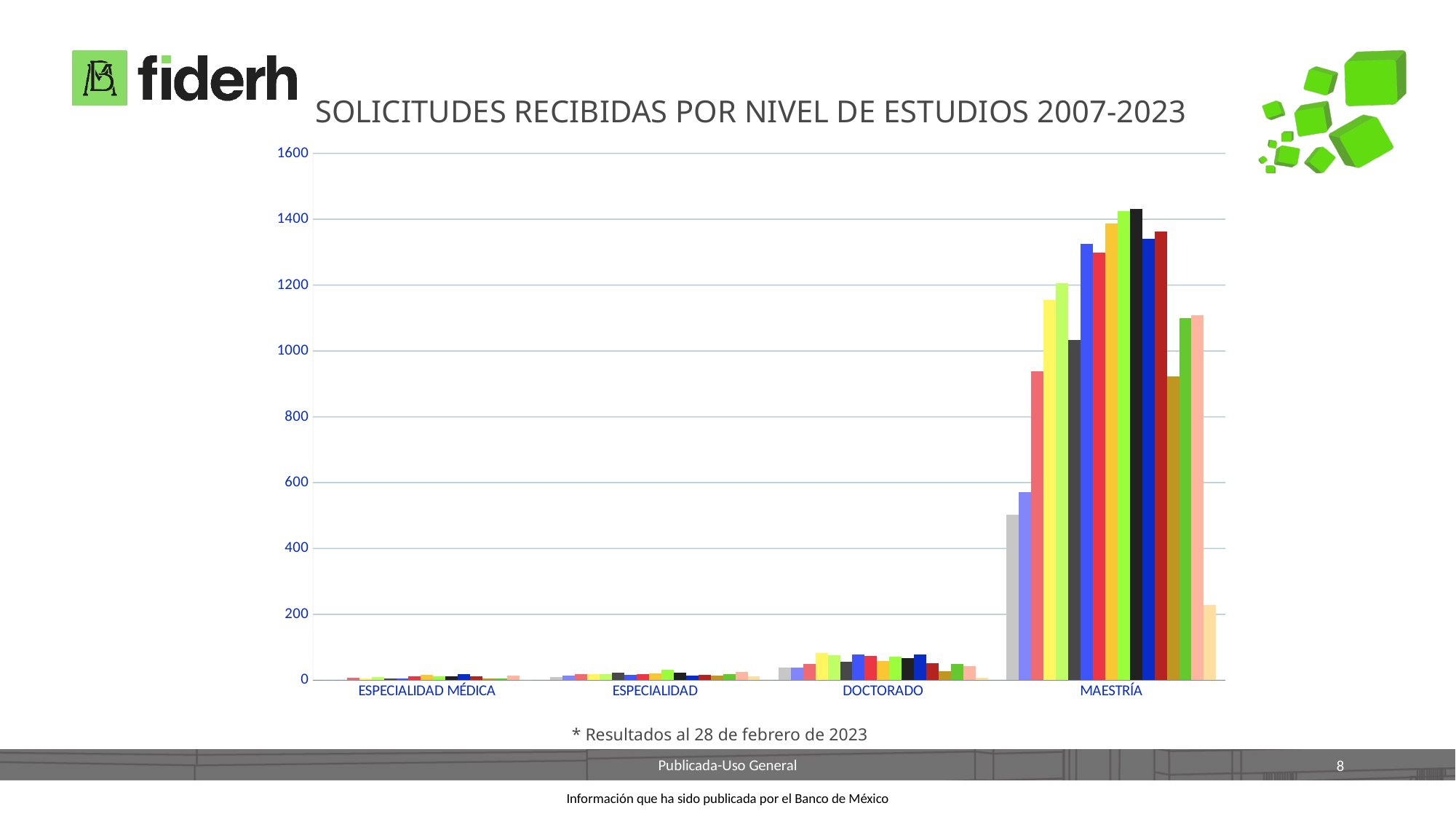
Is the tallest bar for DOCTORADO greater or less than 200? less What kind of chart is shown on the slide? bar chart Which category has taller bars, MAESTRÍA or DOCTORADO? MAESTRÍA Is the tallest bar for ESPECIALIDAD greater or less than 200? less Is the tallest bar for MAESTRÍA greater or less than 1200? greater What is the maximum value shown on the vertical axis? 1600 What is the title of the chart? SOLICITUDES RECIBIDAS POR NIVEL DE ESTUDIOS 2007-2023 Which category has the highest bars in the chart? MAESTRÍA How many study-level categories are shown on the x axis? 4